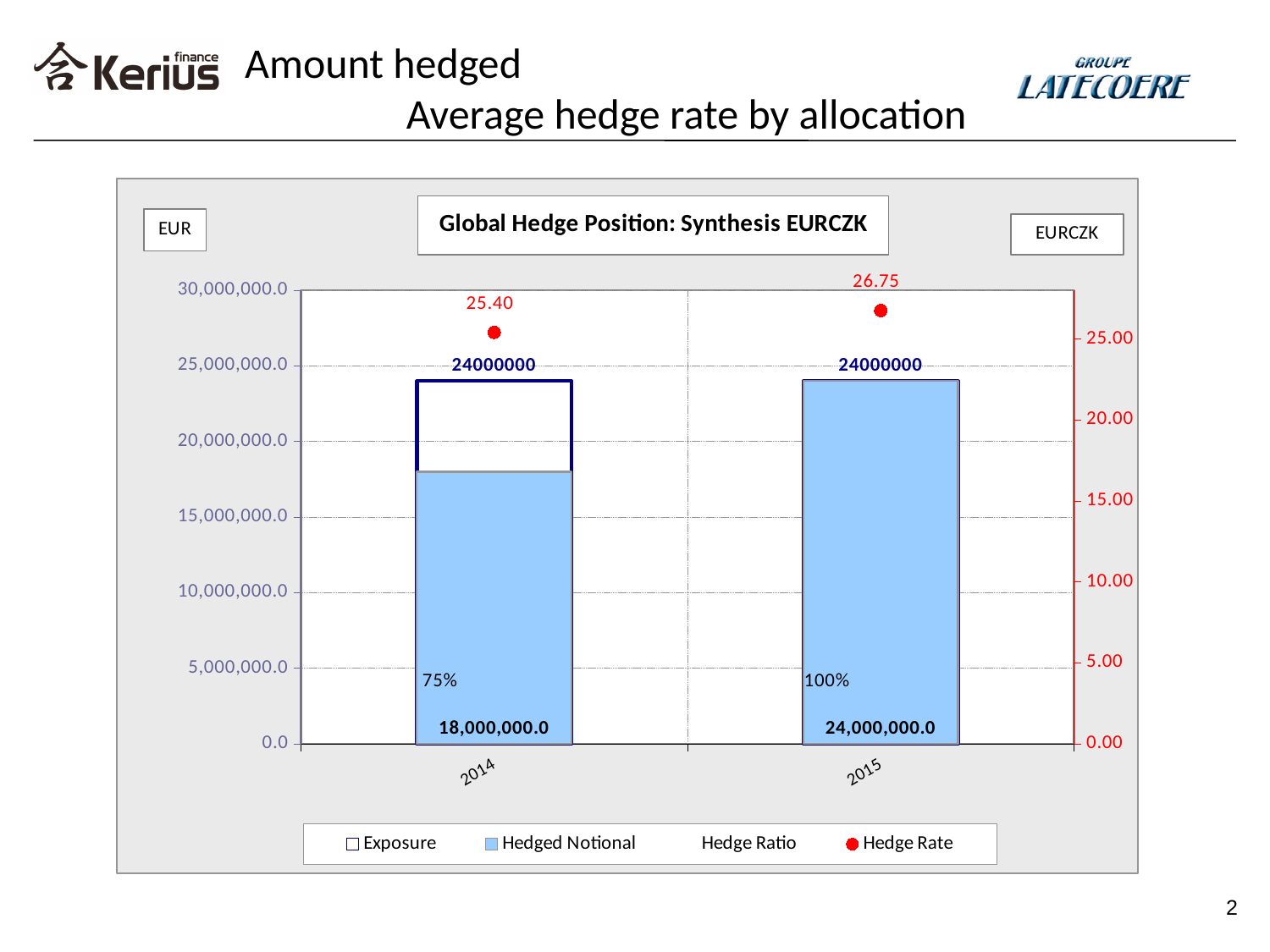
What is the difference between the Hedged Notional for 2015 and 2014? 6,000,000.0 How many years are shown on the x axis? 2 What is the Hedged Notional for 2015? 24,000,000.0 What is the Hedged Notional for 2014? 18,000,000.0 How many series does the legend list? 4 What is the title of the chart? Global Hedge Position: Synthesis EURCZK What is the Hedge Ratio for 2014? 75% What is the Hedge Rate for 2014? 25.40 Which year has the lower Hedged Notional? 2014 Which year has the higher Hedge Rate? 2015 What is the Exposure for 2015? 24000000 What is the Hedge Rate for 2015? 26.75